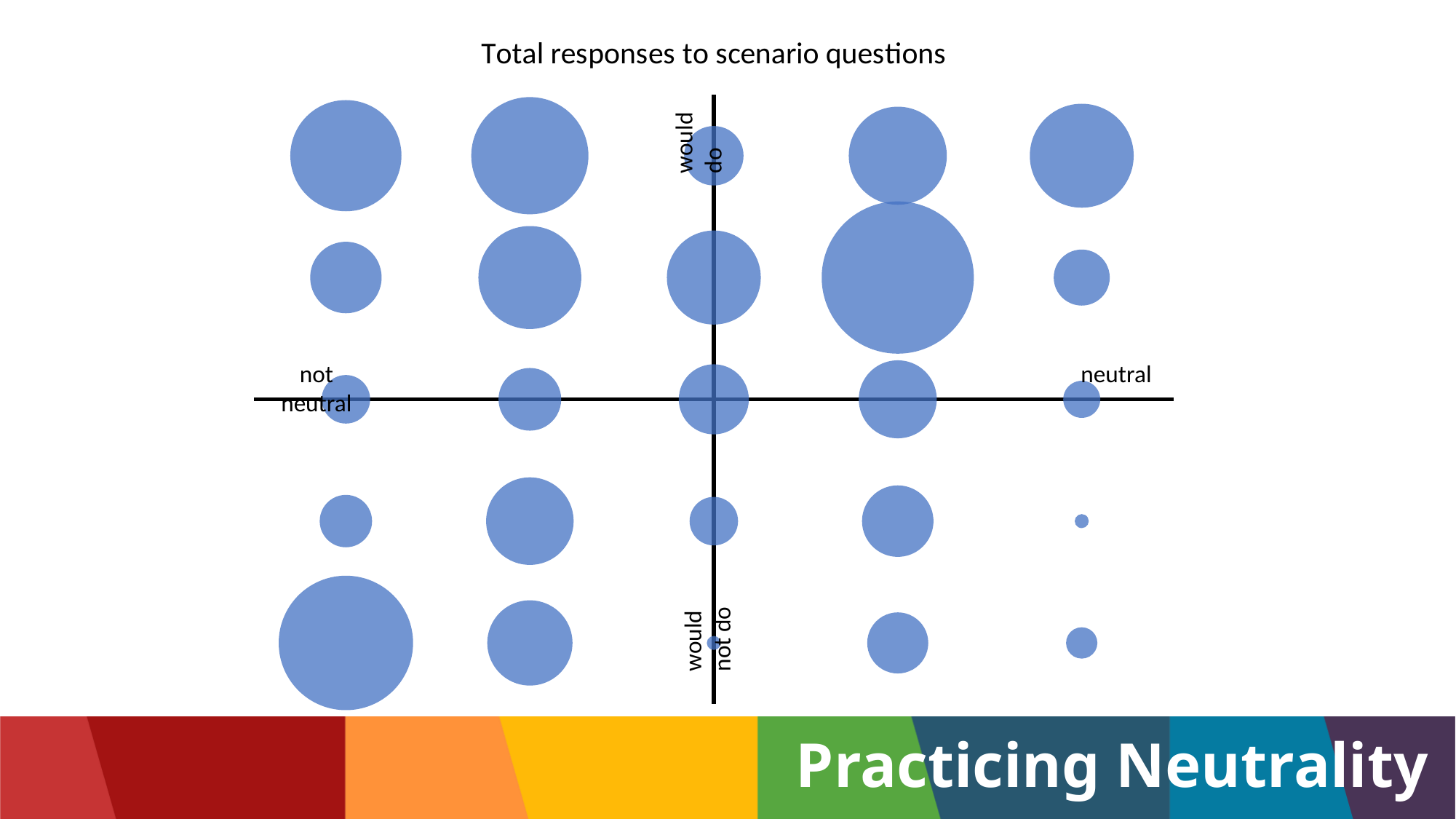
Which is larger: the bubble in the top-left corner or the bubble in the top-right corner? top-left How many bubbles are plotted on the chart? 25 How many rows of bubbles are there down the chart? 5 In which quadrant of the chart is the largest bubble located? upper right Is the largest bubble above or below the horizontal axis? above Which is larger: the bubble in the bottom-left corner or the bubble in the bottom-right corner? bottom-left What kind of chart is shown on the slide? bubble chart How many columns of bubbles are there across the chart? 5 What is the title of the chart? Total responses to scenario questions What label appears at the right end of the horizontal axis? neutral